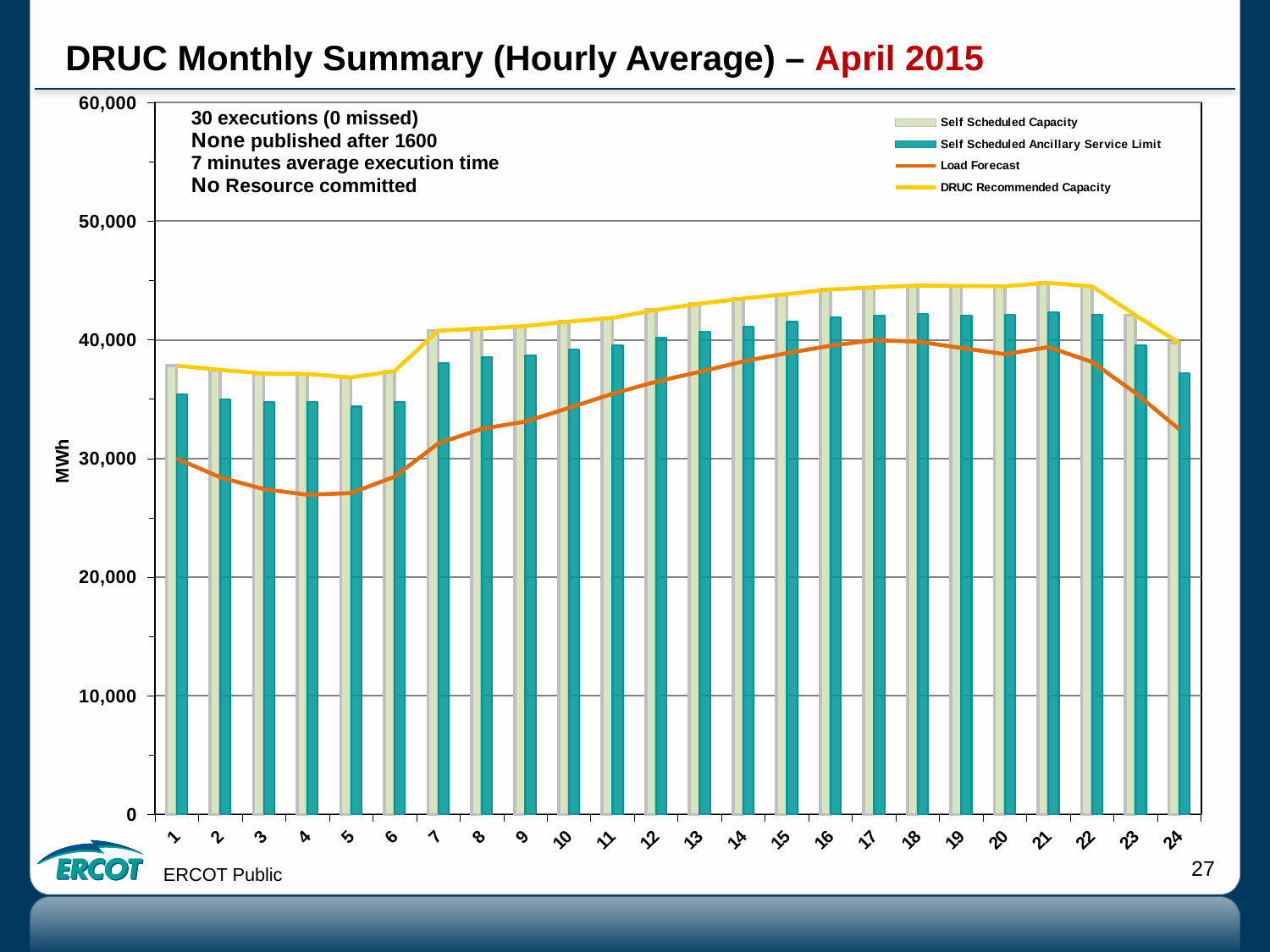
Is the DRUC Recommended Capacity value at hour 21 greater or less than 40,000? greater Does the Load Forecast rise or fall from hour 21 to hour 24? fall Is the Self Scheduled Ancillary Service Limit value at hour 1 greater or less than 40,000? less How many series does the chart legend list? 4 Does the Load Forecast rise or fall from hour 6 to hour 17? rise What kind of chart is shown on the slide? Combined bar and line chart Which is larger: the Load Forecast at hour 1 or the Load Forecast at hour 12? hour 12 Is the Load Forecast value at hour 12 greater or less than 40,000? less What unit is shown on the y axis of the chart? MWh How many hours are shown along the x axis of the chart? 24